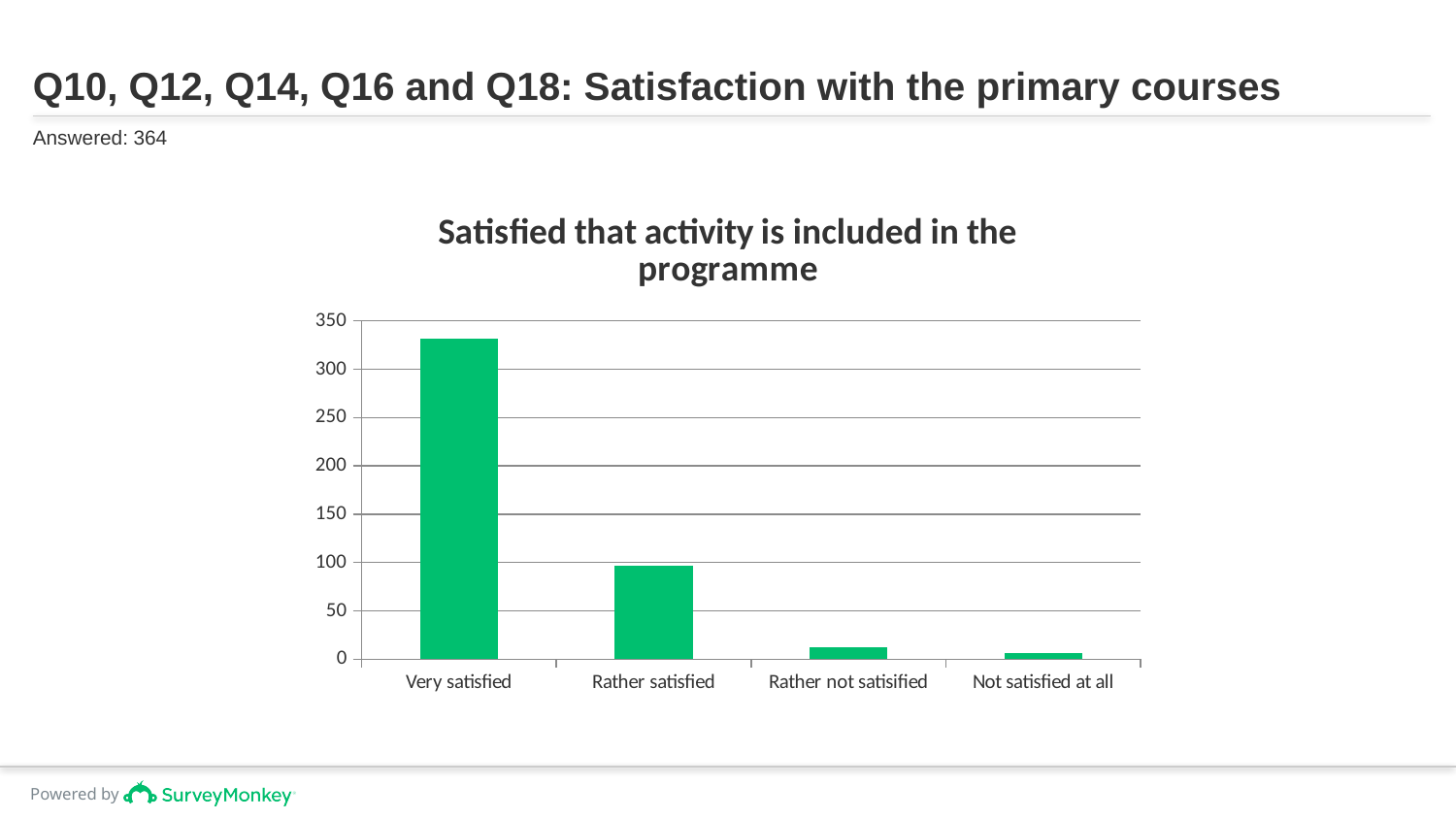
Is the value for Very satisfied greater or less than 300? greater Which category has the highest value? Very satisfied Which category has the lowest value? Not satisfied at all What colour are the bars in the chart? green Do the values rise or fall from left to right along the x axis? fall Is the value for Rather not satisified greater or less than 50? less Which is larger, the value for Rather satisfied or the value for Rather not satisified? Rather satisfied What kind of chart is shown on the slide? bar chart What is the highest value shown on the y axis? 350 What is the title of the chart? Satisfied that activity is included in the programme How many categories are shown on the x axis of the chart? 4